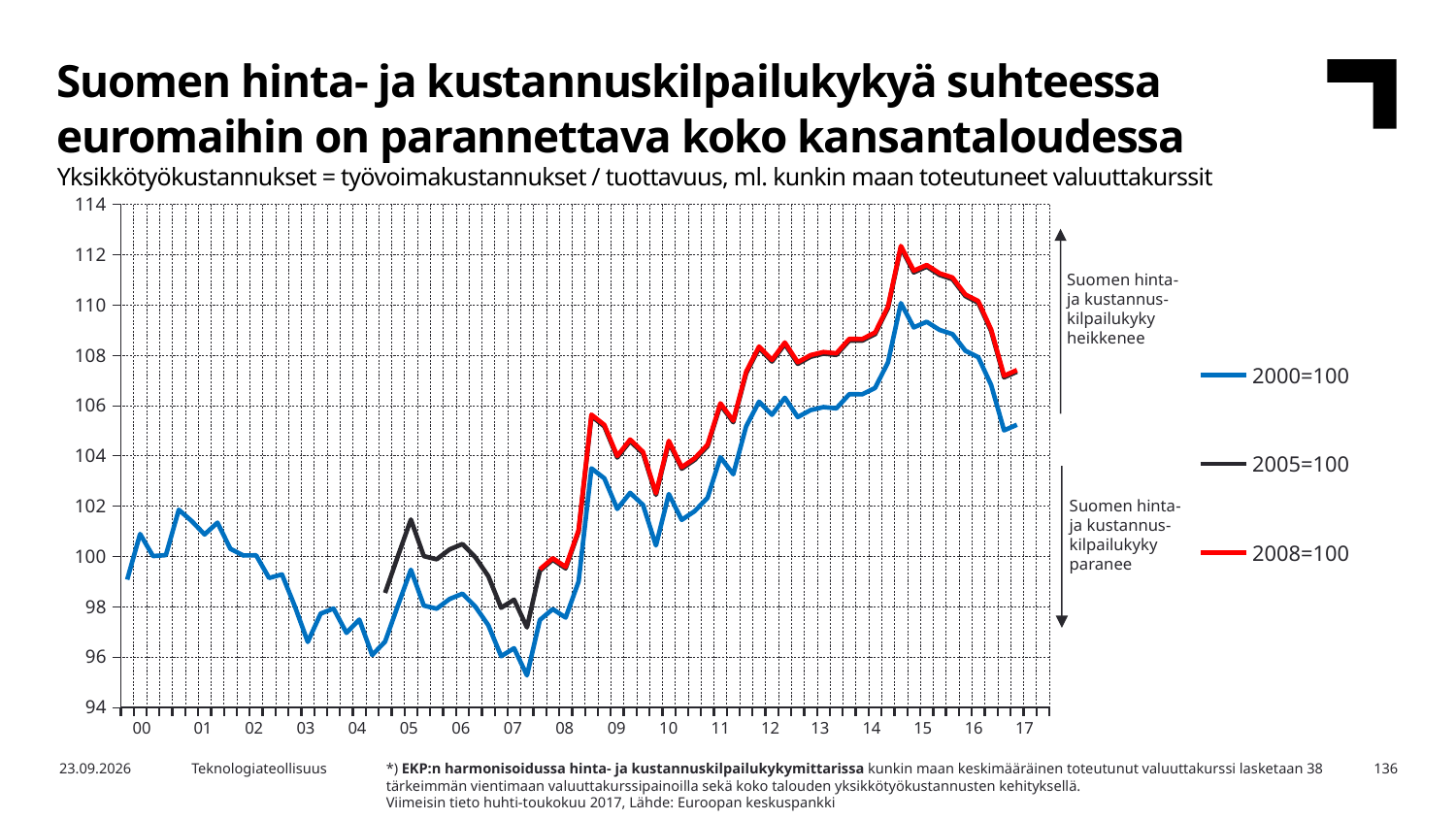
Does the 2000=100 series rise or fall between 2008 and 2015? rise How many series does the legend list? 3 At the end of the chart in 2017, which series is higher: 2000=100 or 2008=100? 2008=100 Is the peak value of the 2008=100 series (around 2014–15) greater or less than 110? greater Which series reaches the highest value anywhere on the chart? 2008=100 How many year labels are shown on the x axis? 18 Is the lowest value of the 2000=100 series (around 2007) greater or less than 96? less What are the three series named in the legend? 2000=100, 2005=100, 2008=100 Does the 2008=100 series rise or fall between 2015 and 2017? fall Which series is drawn in red? 2008=100 Is the peak value of the 2000=100 series (around 2014–15) greater or less than 108? greater What kind of chart is shown on the slide? line chart